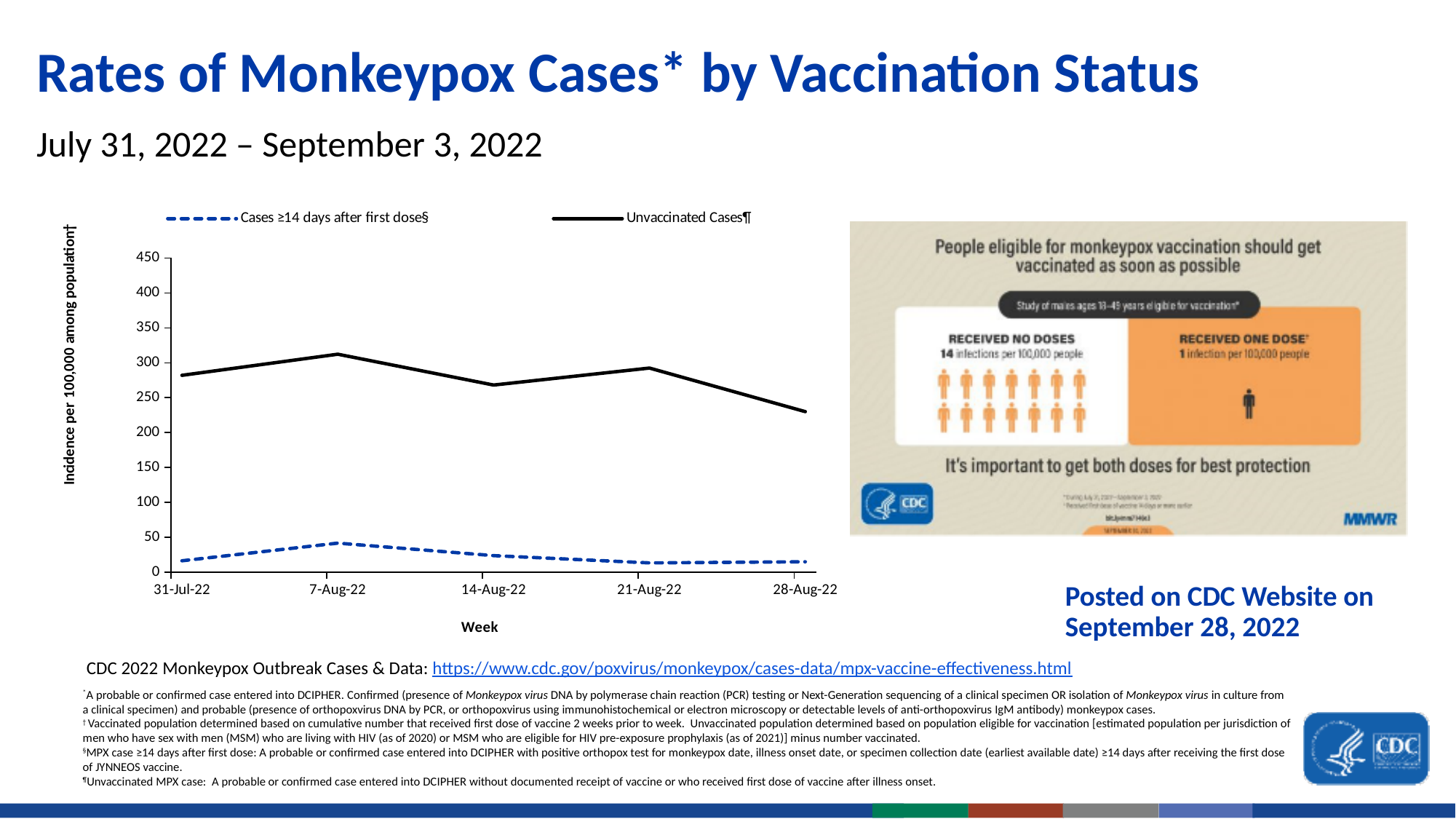
How many series does the chart legend list? 2 Is the value for Unvaccinated Cases on 28-Aug-22 greater or less than 250? less What is the title of the chart's y axis? Incidence per 100,000 among population† Do the Unvaccinated Cases rise or fall from 21-Aug-22 to 28-Aug-22? fall Is the value for Cases ≥14 days after first dose on 7-Aug-22 greater or less than 50? less On 14-Aug-22, which series has the larger value: Unvaccinated Cases or Cases ≥14 days after first dose? Unvaccinated Cases Is the value for Unvaccinated Cases on 7-Aug-22 greater or less than 300? greater Which week has the highest value for Cases ≥14 days after first dose? 7-Aug-22 Which week has the lowest value for Unvaccinated Cases? 28-Aug-22 What kind of chart is shown on the slide? line chart Which week has the highest value for Unvaccinated Cases? 7-Aug-22 How many weeks are plotted along the x axis of the chart? 5